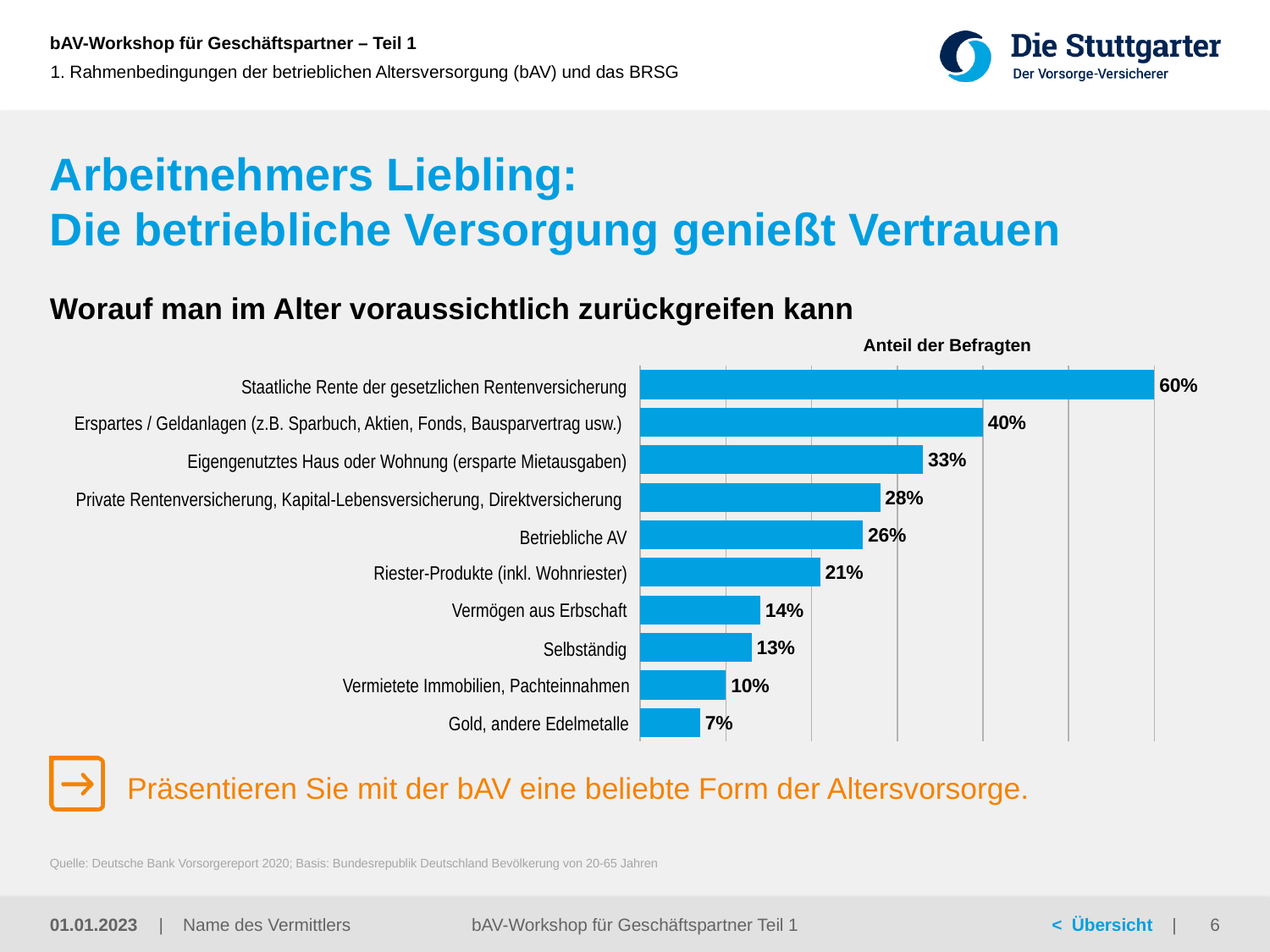
What is the value for Eigengenutztes Haus oder Wohnung (ersparte Mietausgaben)? 33% Which category has the lowest value? Gold, andere Edelmetalle What is the value for Vermietete Immobilien, Pachteinnahmen? 10% What is the value for Riester-Produkte (inkl. Wohnriester)? 21% What is the difference between the values for Staatliche Rente der gesetzlichen Rentenversicherung and Ersparte / Geldanlagen? 20% How many categories are shown in the chart? 10 Which is larger, the value for Vermögen aus Erbschaft or the value for Selbständig? Vermögen aus Erbschaft What is the difference between the values for Betriebliche AV and Riester-Produkte (inkl. Wohnriester)? 5% What kind of chart is shown on the slide? Bar chart Which category has the highest value? Staatliche Rente der gesetzlichen Rentenversicherung What is the axis title shown above the bars? Anteil der Befragten What is the value for Betriebliche AV? 26%